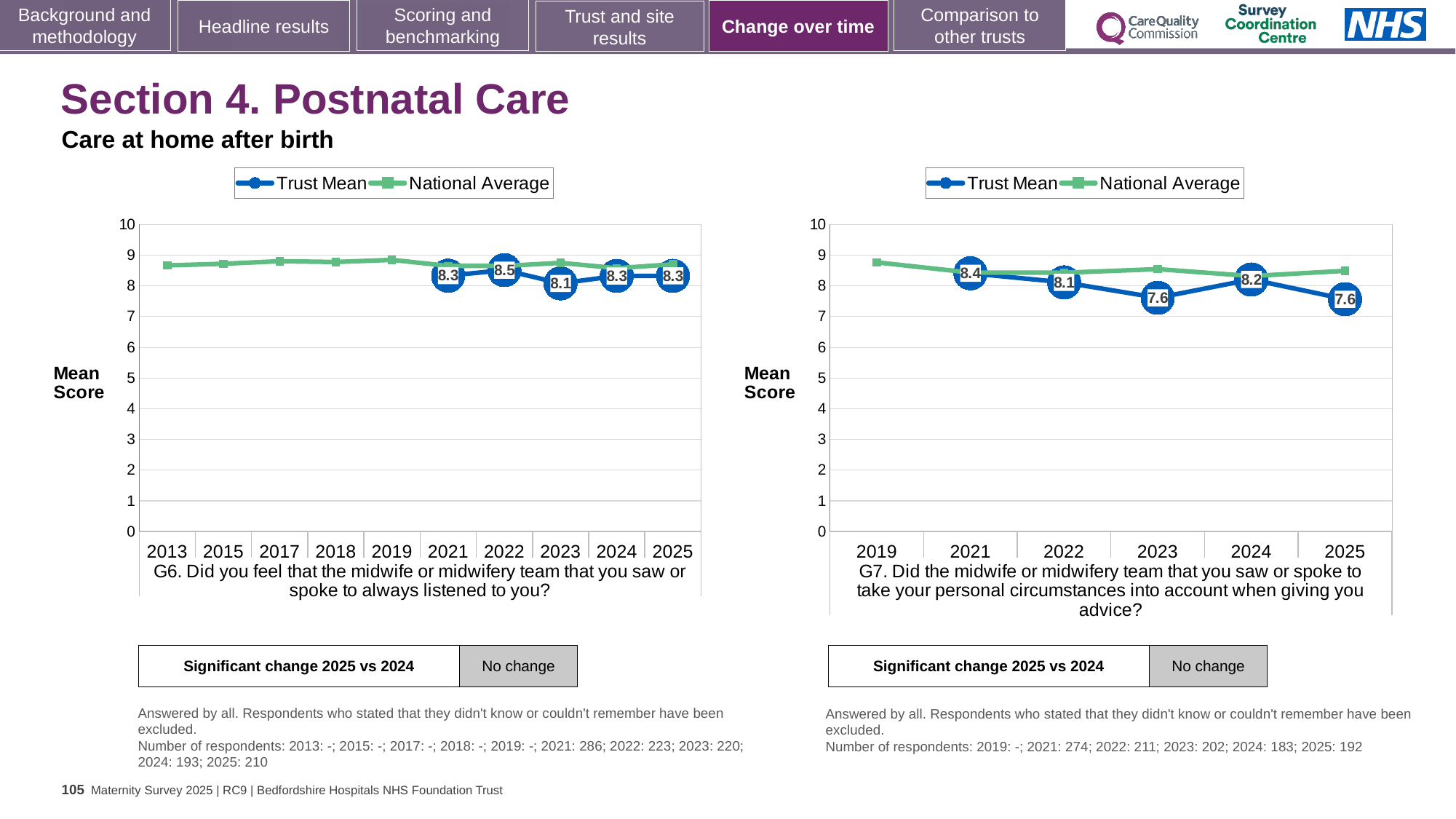
In the G6 chart on the left, which is larger: the Trust Mean in 2022 or in 2023? 2022 In the G6 chart on the left, what is the Trust Mean for 2022? 8.5 What type of chart is the G7 chart on the right? Line chart How many series does the legend of the G6 chart on the left list? 2 In the G7 chart on the right, what is the Trust Mean for 2025? 7.6 In the G6 chart on the left, is the National Average for 2013 greater or less than 8? greater In the G6 chart on the left, which year has the highest labelled Trust Mean? 2022 In the G6 chart on the left, what is the Trust Mean for 2023? 8.1 In the G7 chart on the right, what is the difference between the Trust Mean in 2021 and in 2023? 0.8 In the G7 chart on the right, which year has the highest Trust Mean? 2021 How many years are shown on the x axis of the G7 chart on the right? 6 In the G7 chart on the right, what is the Trust Mean for 2021? 8.4